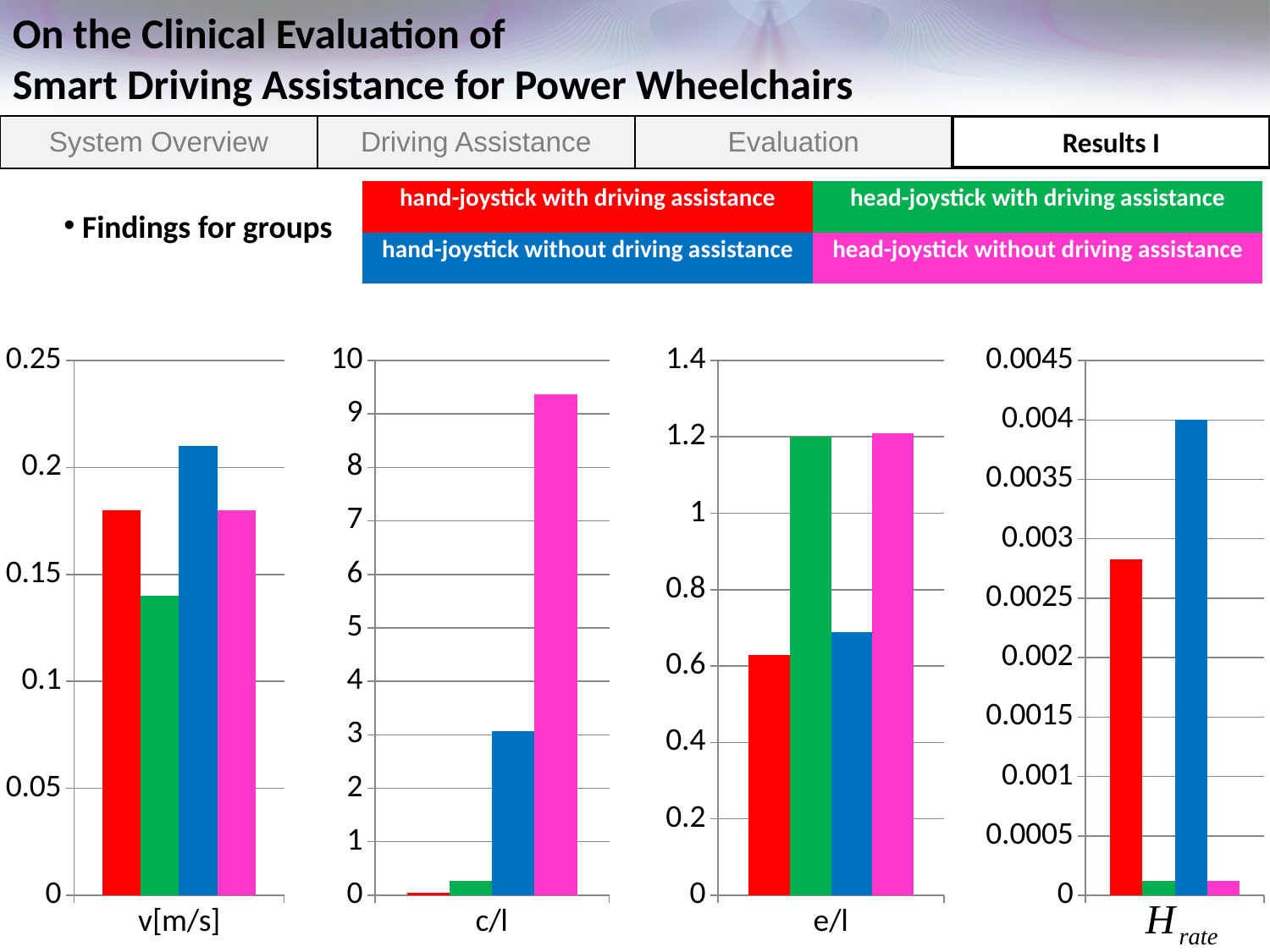
In the v[m/s] chart, which group has the highest value? hand-joystick without driving assistance In the e/l chart, is the value for head-joystick with driving assistance greater or less than 1? greater In the H_rate chart, which group has the highest value? hand-joystick without driving assistance How many groups does the legend list? 4 In the v[m/s] chart, is the value for hand-joystick without driving assistance greater or less than 0.2? greater In the c/l chart, which group has the highest value? head-joystick without driving assistance What kind of chart is the e/l chart? bar chart In the v[m/s] chart, which group has the lowest value? head-joystick with driving assistance In the e/l chart, which is larger: the value for hand-joystick with driving assistance or hand-joystick without driving assistance? hand-joystick without driving assistance In the c/l chart, is the value for head-joystick without driving assistance greater or less than 9? greater